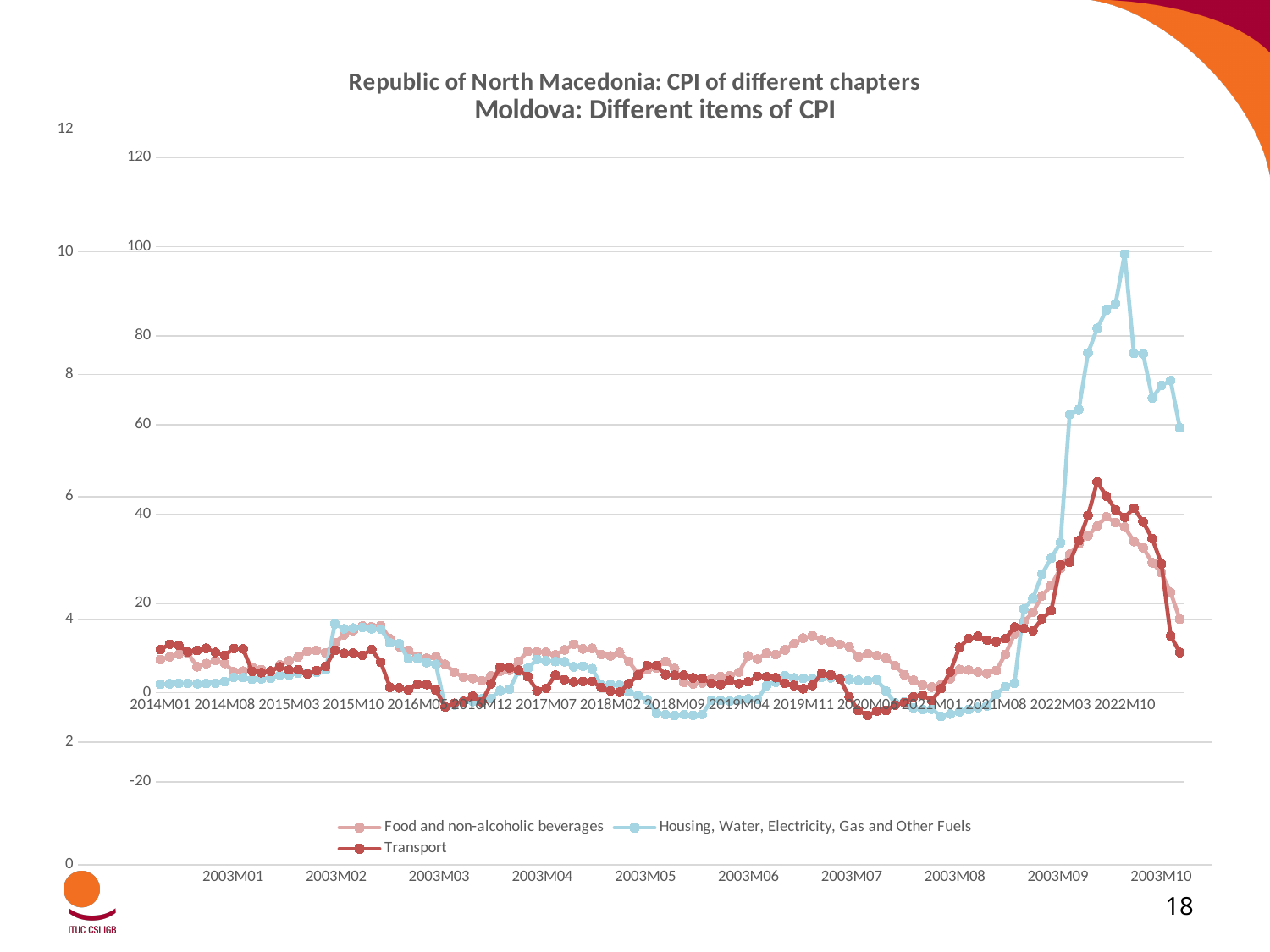
On the Moldova: Different items of CPI chart, does the Housing, Water, Electricity, Gas and Other Fuels series rise or fall between 2021M08 and 2022M03? rise On the Moldova: Different items of CPI chart, what kind of chart is used to show the data? line chart On the Moldova: Different items of CPI chart, is the peak value of the Transport series greater or less than 40? greater On the Moldova: Different items of CPI chart, how many series does the legend list? 3 On the Moldova: Different items of CPI chart, is the peak value of the Housing, Water, Electricity, Gas and Other Fuels series greater or less than 80? greater On the Moldova: Different items of CPI chart, at its peak, which series is higher: Transport or Food and non-alcoholic beverages? Transport On the Moldova: Different items of CPI chart, what is the highest value shown on the vertical axis? 120 On the Moldova: Different items of CPI chart, is the peak value of the Food and non-alcoholic beverages series greater or less than 20? greater On the Moldova: Different items of CPI chart, which series is drawn in light blue? Housing, Water, Electricity, Gas and Other Fuels On the Moldova: Different items of CPI chart, which series reaches the highest value on the chart? Housing, Water, Electricity, Gas and Other Fuels